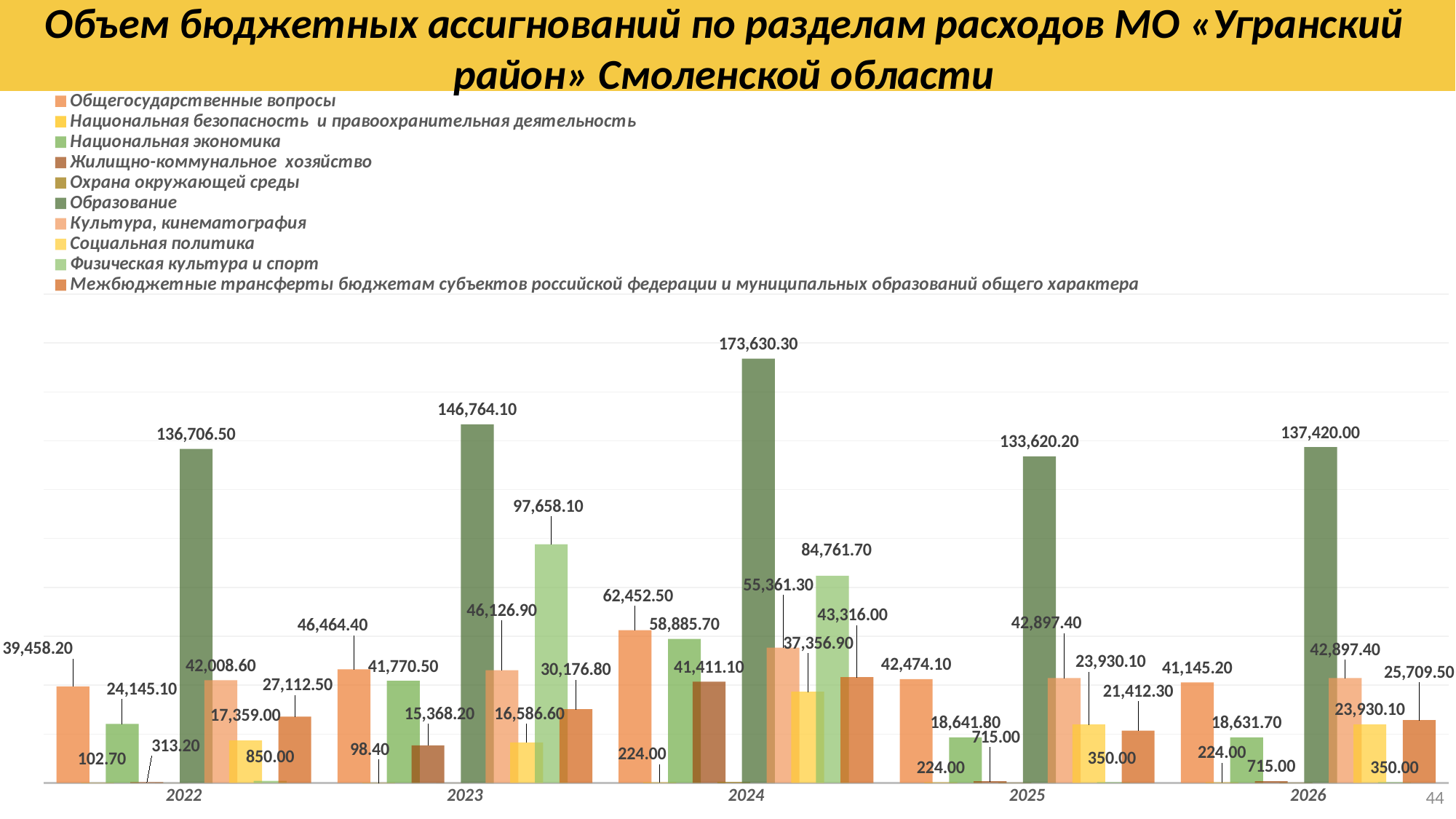
What is the value for Межбюджетные трансферты бюджетам субъектов российской федерации и муниципальных образований общего характера in 2026? 25,709.50 Does the value for Образование rise or fall from 2022 to 2024? Rise How many series does the legend list? 10 What kind of chart is shown on the slide? Bar chart How many years are shown along the x axis? 5 What is the difference between the Образование values for 2023 and 2022? 10,057.60 In which year is the value for Образование the lowest? 2025 In which year is the value for Образование the highest? 2024 What is the value for Образование in 2024? 173,630.30 What is the title of the chart? Объем бюджетных ассигнований по разделам расходов МО «Угранский район» Смоленской области In 2024, which is larger: Общегосударственные вопросы or Национальная экономика? Общегосударственные вопросы What is the value for Физическая культура и спорт in 2023? 97,658.10